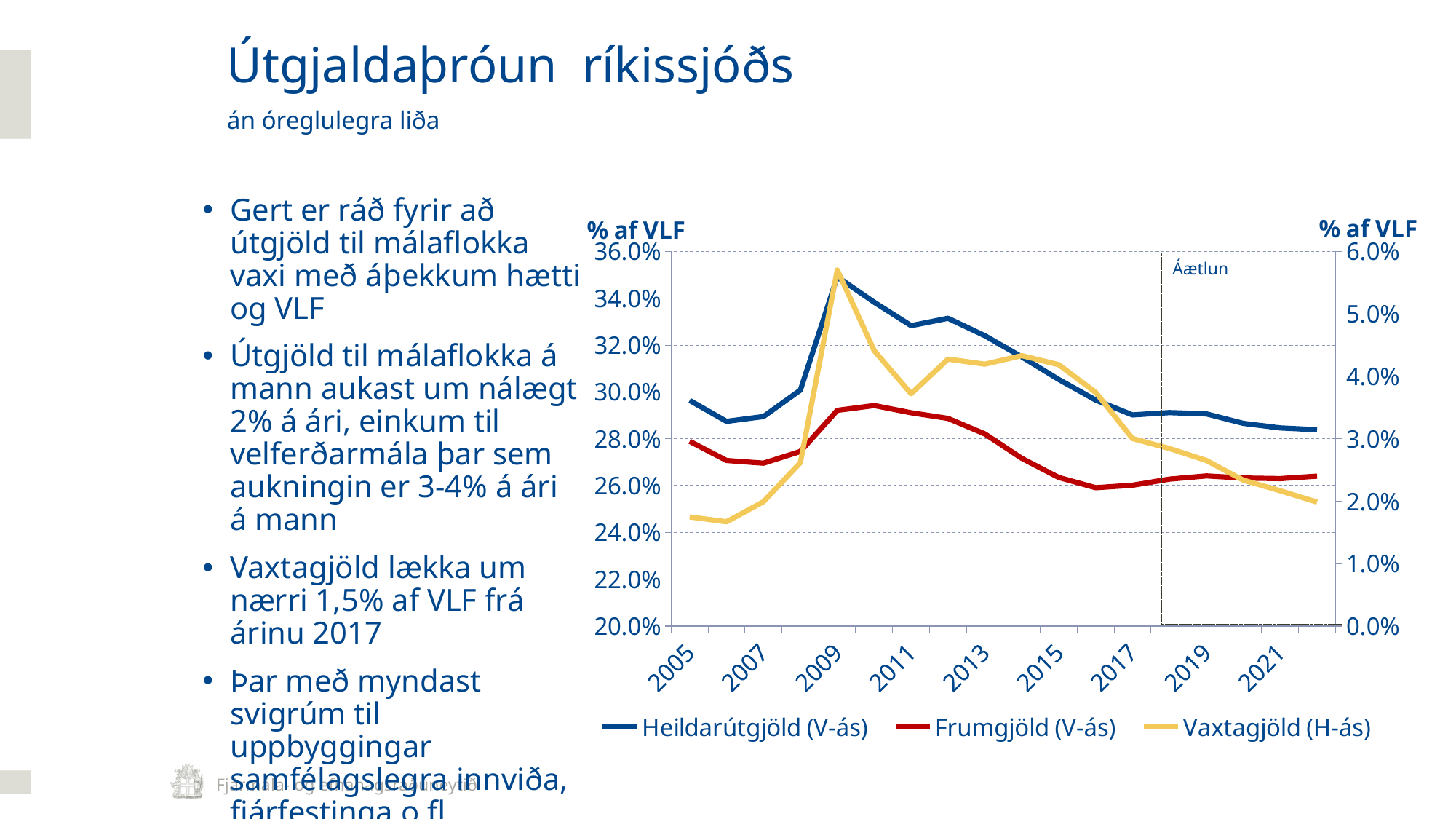
How many series does the chart legend list? 3 Which series in the chart is plotted against the right-hand axis (H-ás)? Vaxtagjöld (H-ás) Is the value for Heildarútgjöld (V-ás) in 2021 greater or less than 30.0%? less Is the value for Vaxtagjöld (H-ás) in 2005 greater or less than 2.0% on the right-hand axis? less In 2009, which is larger: Heildarútgjöld (V-ás) or Frumgjöld (V-ás)? Heildarútgjöld (V-ás) What kind of chart is shown on the slide? line chart Is the value for Vaxtagjöld (H-ás) in 2009 greater or less than 5.0% on the right-hand axis? greater In which year does the Heildarútgjöld (V-ás) line reach its highest value? 2009 What label is shown on both vertical axes of the chart? % af VLF Does the Heildarútgjöld (V-ás) line generally rise or fall from 2009 to the end of the series? fall In which year does the Vaxtagjöld (H-ás) line reach its highest value? 2009